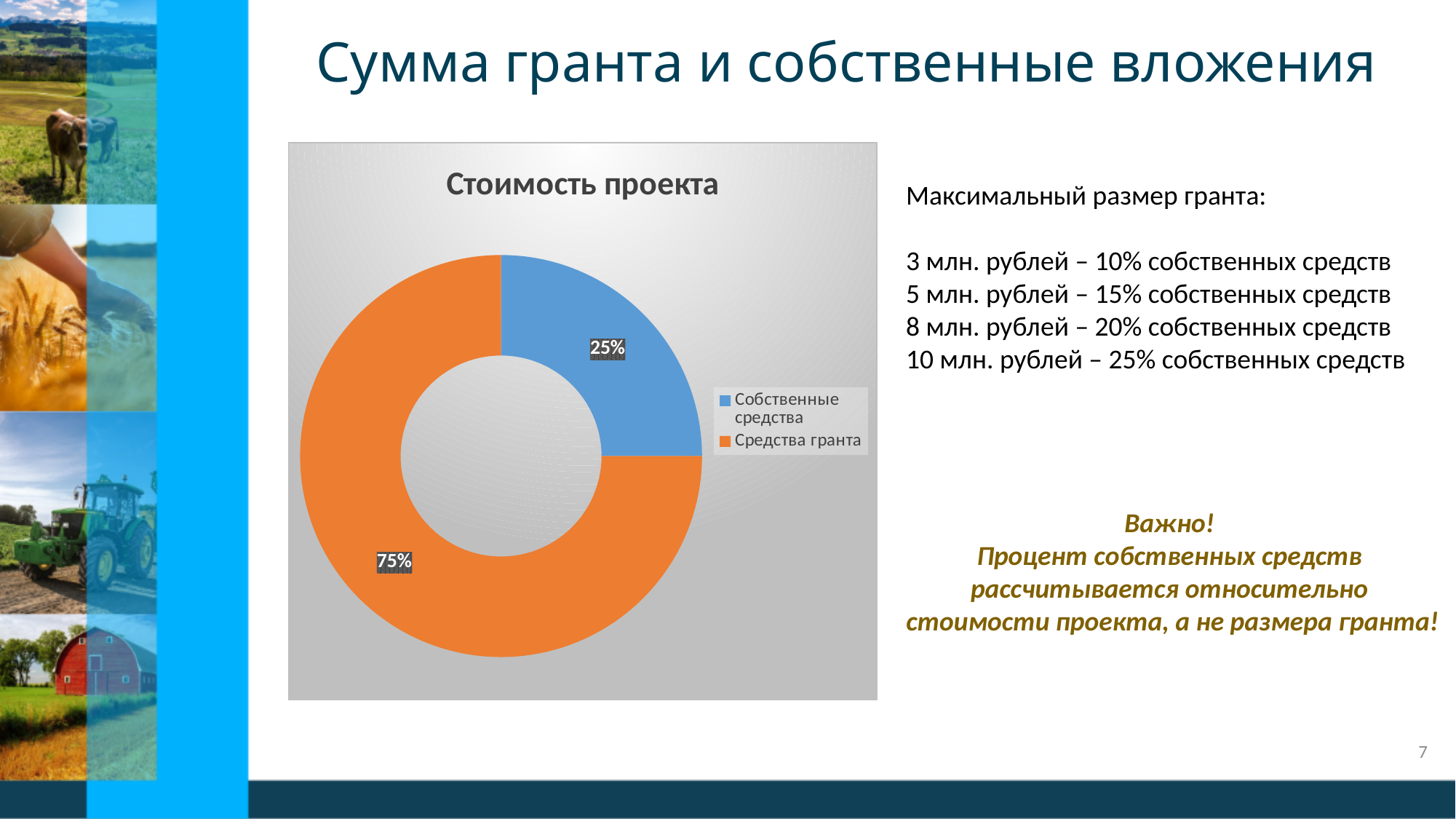
How many categories does the chart show? 2 Which category has the largest share in the chart? Средства гранта Which is larger: the share for Средства гранта or for Собственные средства? Средства гранта What is the difference in percentage points between the share for Средства гранта and the share for Собственные средства? 50% What is the title of the chart? Стоимость проекта What share of the chart is labelled for Собственные средства? 25% What kind of chart is shown on the slide? Doughnut (pie) chart What share of the chart is labelled for Средства гранта? 75% How many entries does the legend list? 2 Which category has the smallest share in the chart? Собственные средства What colour represents Средства гранта in the chart? Orange